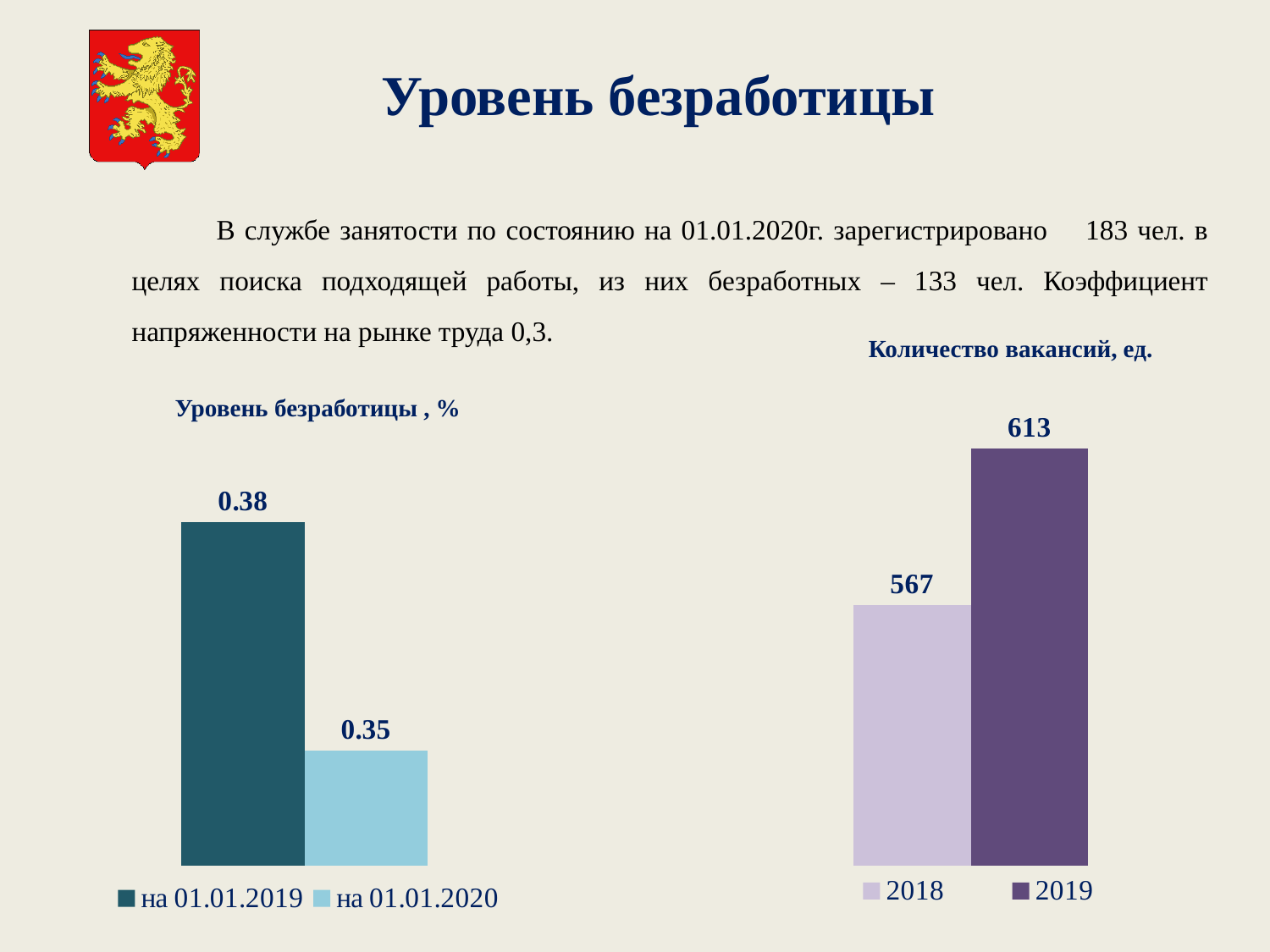
In the chart titled "Уровень безработицы , %", what is the value for на 01.01.2019? 0.38 In the chart titled "Уровень безработицы , %", what is the value for на 01.01.2020? 0.35 In the chart titled "Количество вакансий, ед.", what is the difference between the values for 2019 and 2018? 46 In the chart titled "Количество вакансий, ед.", what is the value for 2019? 613 In the chart titled "Уровень безработицы , %", how many series does the legend list? 2 In the chart titled "Количество вакансий, ед.", is the value for 2019 larger or smaller than the value for 2018? larger In the chart titled "Количество вакансий, ед.", what is the value for 2018? 567 In the chart titled "Уровень безработицы , %", which series has the higher value? на 01.01.2019 In the chart titled "Количество вакансий, ед.", which year has the lower value? 2018 In the chart titled "Уровень безработицы , %", what is the difference between the values for на 01.01.2019 and на 01.01.2020? 0.03 In the chart titled "Количество вакансий, ед.", what colour is the bar for 2019? dark purple What kind of chart is the chart titled "Количество вакансий, ед."? bar chart